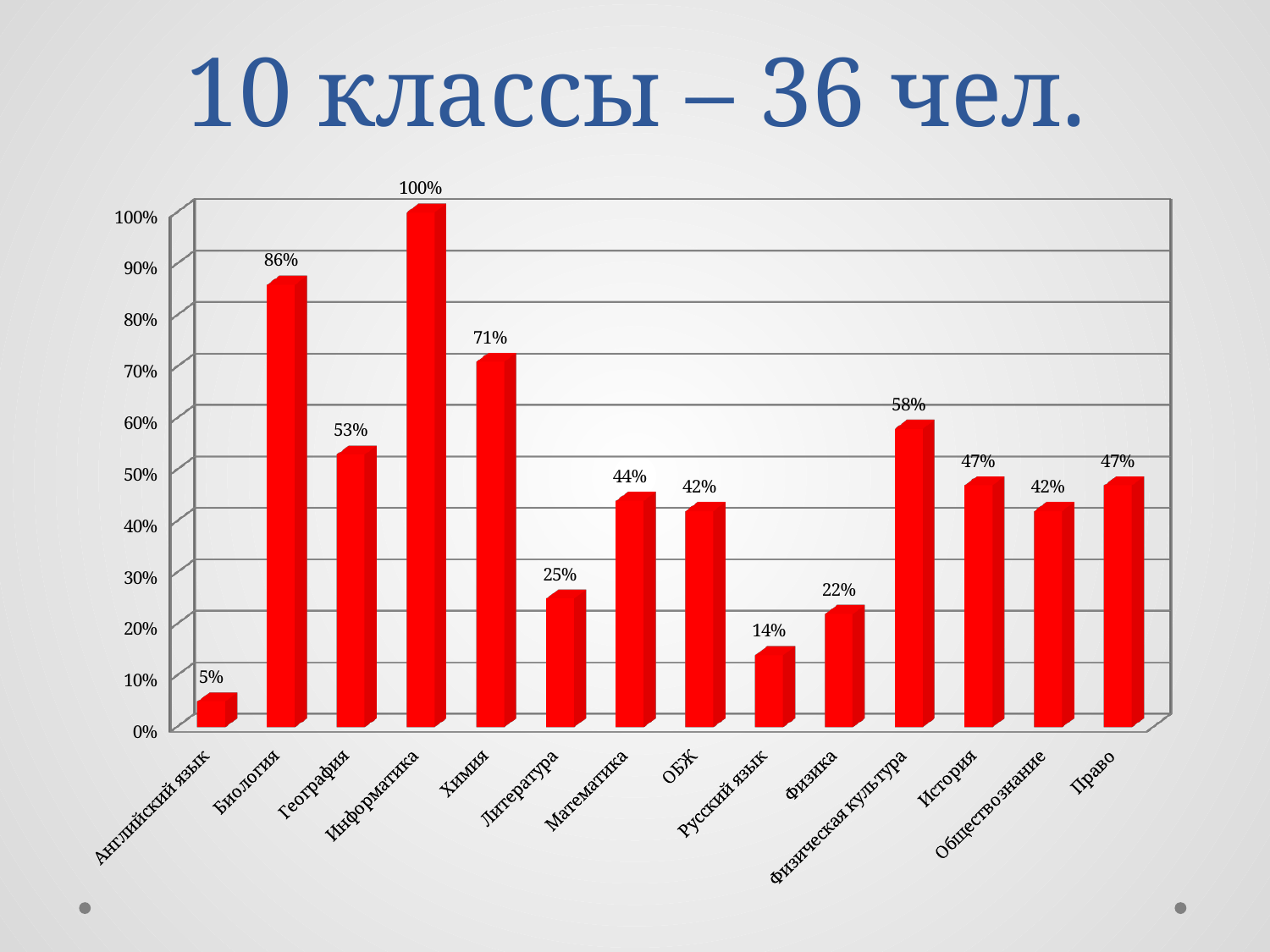
Is the value for География greater or less than 50%? greater What is the difference between the values for Биология and Химия? 15% What is the value for Физическая культура? 58% What is the title of the slide? 10 классы – 36 чел. How many categories are shown on the x axis? 14 What is the value for Русский язык? 14% Which category has the lowest value? Английский язык Which category has the highest value? Информатика What is the value for Информатика? 100% What colour are the bars in the chart? red What kind of chart is shown on the slide? bar chart Which is larger, the value for Математика or the value for Физика? Математика